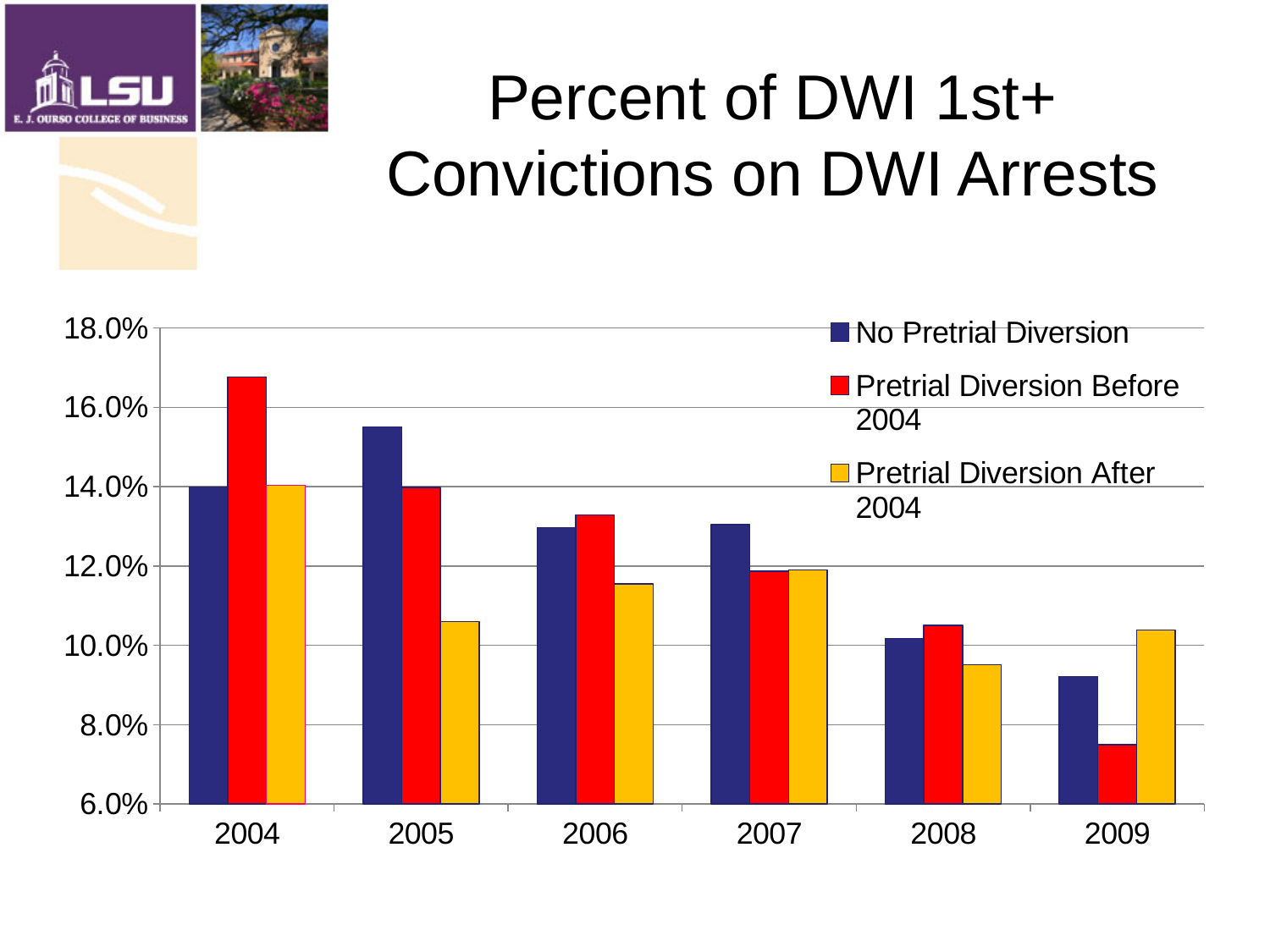
In which year is the Pretrial Diversion Before 2004 bar highest? 2004 Is the value for No Pretrial Diversion in 2005 greater or less than 14.0%? greater How many years are shown on the x axis? 6 Is the value for Pretrial Diversion After 2004 in 2005 greater or less than 12.0%? less In which year is the No Pretrial Diversion bar highest? 2005 In which year is the No Pretrial Diversion bar lowest? 2009 What kind of chart is shown on the slide? bar chart Is the value for Pretrial Diversion Before 2004 in 2009 greater or less than 8.0%? less In 2009, which is larger: Pretrial Diversion Before 2004 or Pretrial Diversion After 2004? Pretrial Diversion After 2004 Does the No Pretrial Diversion series rise or fall from 2005 to 2009? fall In which year is the Pretrial Diversion Before 2004 bar lowest? 2009 How many series does the legend list? 3